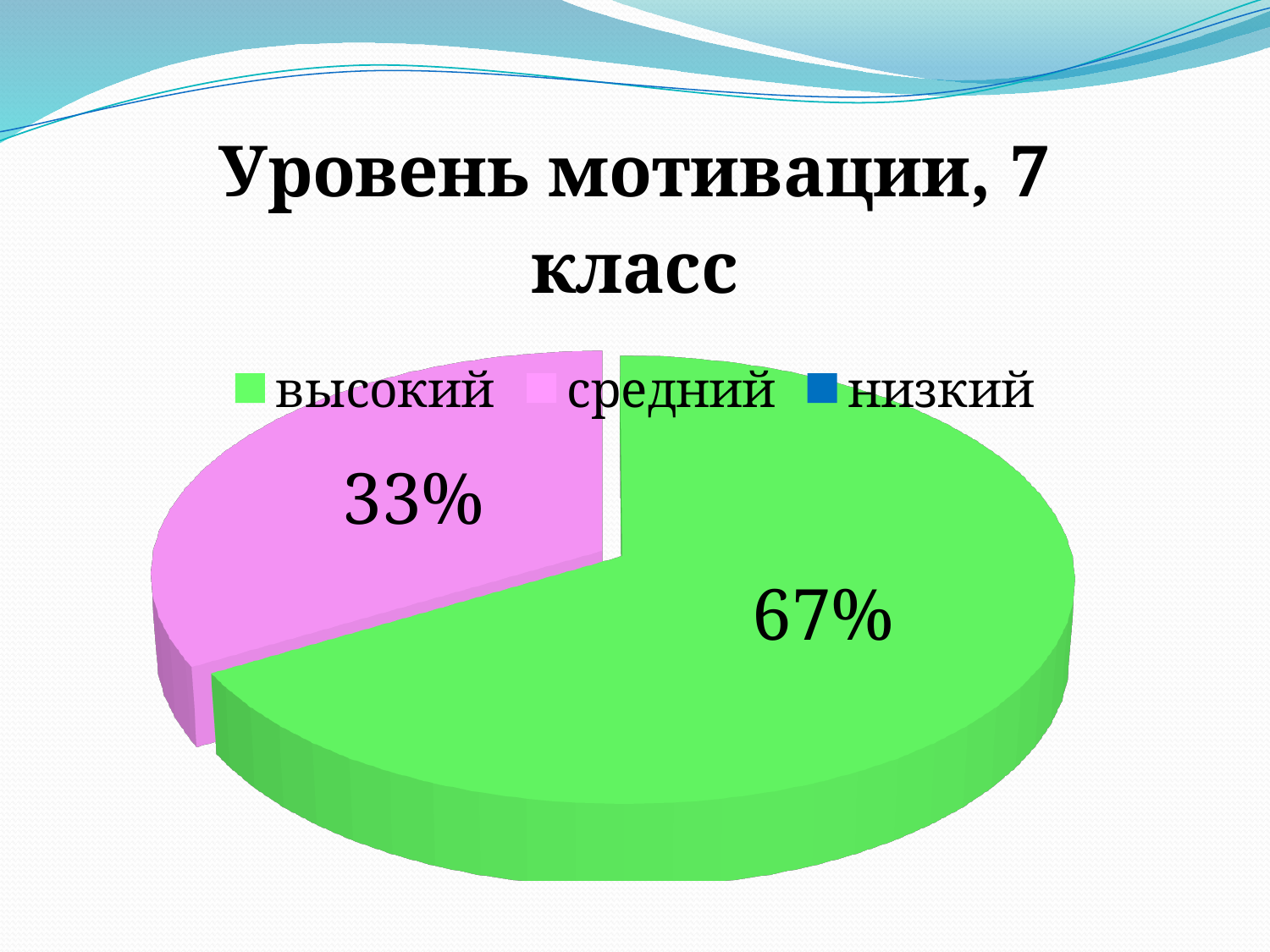
What percentage of the pie is labelled for the "высокий" slice? 67% Is the value for "высокий" greater or less than 50%? greater What colour is the "средний" slice? pink Which of the two labelled slices is larger, "высокий" or "средний"? высокий Which category has the largest slice of the pie? высокий What is the title of the chart? Уровень мотивации, 7 класс Which legend entry has no visible slice in the pie? низкий How many entries does the legend list? 3 What percentage of the pie is labelled for the "средний" slice? 33% What is the difference in percentage points between the "высокий" and "средний" slices? 34 What kind of chart is shown on the slide? pie chart